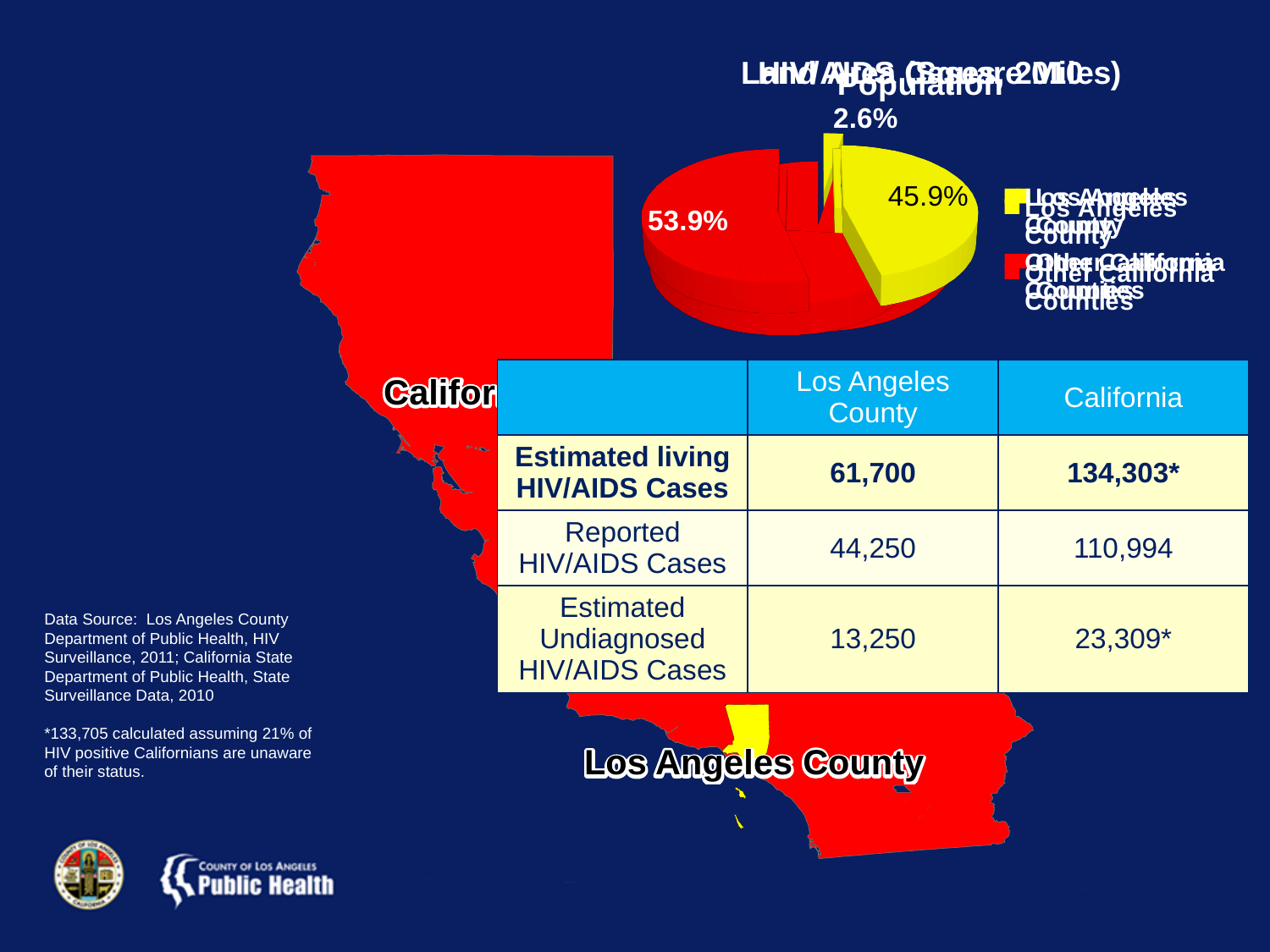
What is the smallest percentage label shown on the pie chart? 2.6% What kind of chart is shown at the top right of the slide? pie chart Which slice of the pie chart has the larger printed value, the red slice or the large yellow slice? the red slice What percentage is printed on the red slice of the pie chart? 53.9% Which colour represents Other California Counties in the pie chart legend? red What percentage is printed on the large yellow slice of the pie chart? 45.9% What is the largest percentage label shown on the pie chart? 53.9% Which colour represents Los Angeles County in the pie chart legend? yellow How many categories does the pie chart's legend list? 2 Is the value printed on the red slice of the pie chart greater or less than 50%? greater